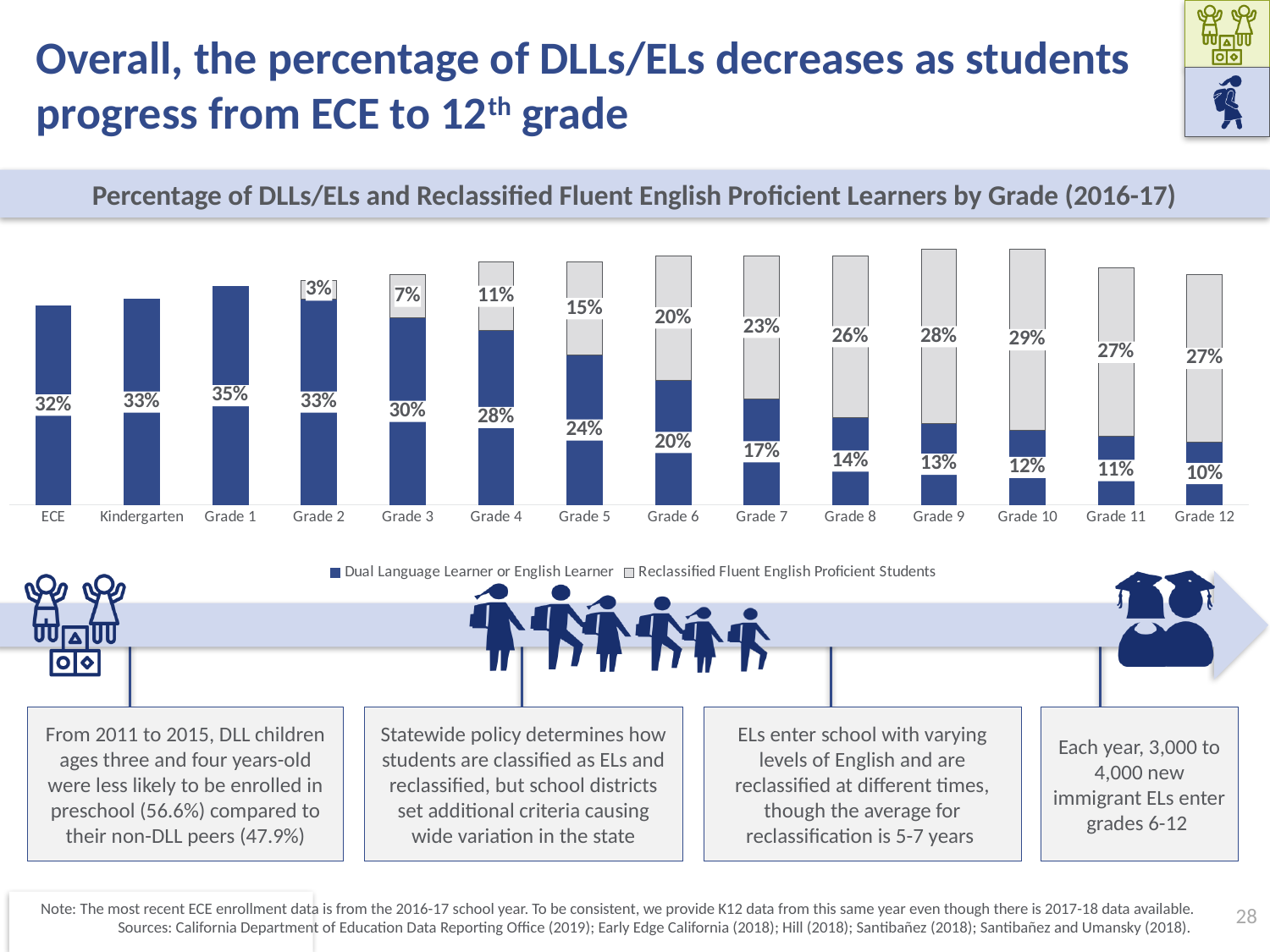
Which grade has the highest percentage of Reclassified Fluent English Proficient Students? Grade 10 Which grade has the lowest percentage of Dual Language Learners or English Learners? Grade 12 Which grade has the highest percentage of Dual Language Learners or English Learners? Grade 1 What is the percentage of Reclassified Fluent English Proficient Students in Grade 10? 29% Is the Dual Language Learner or English Learner percentage higher in Grade 4 or in Grade 7? Grade 4 How many grade categories are shown on the x axis? 14 What is the combined percentage of Dual Language Learners or English Learners and Reclassified Fluent English Proficient Students in Grade 5? 39% What is the difference between the Dual Language Learner or English Learner percentage in ECE and in Grade 12? 22% What is the percentage of Dual Language Learners or English Learners in Grade 1? 35% What type of chart is shown on the slide? stacked bar chart How many series does the legend list? 2 What is the percentage of Dual Language Learners or English Learners in Grade 12? 10%